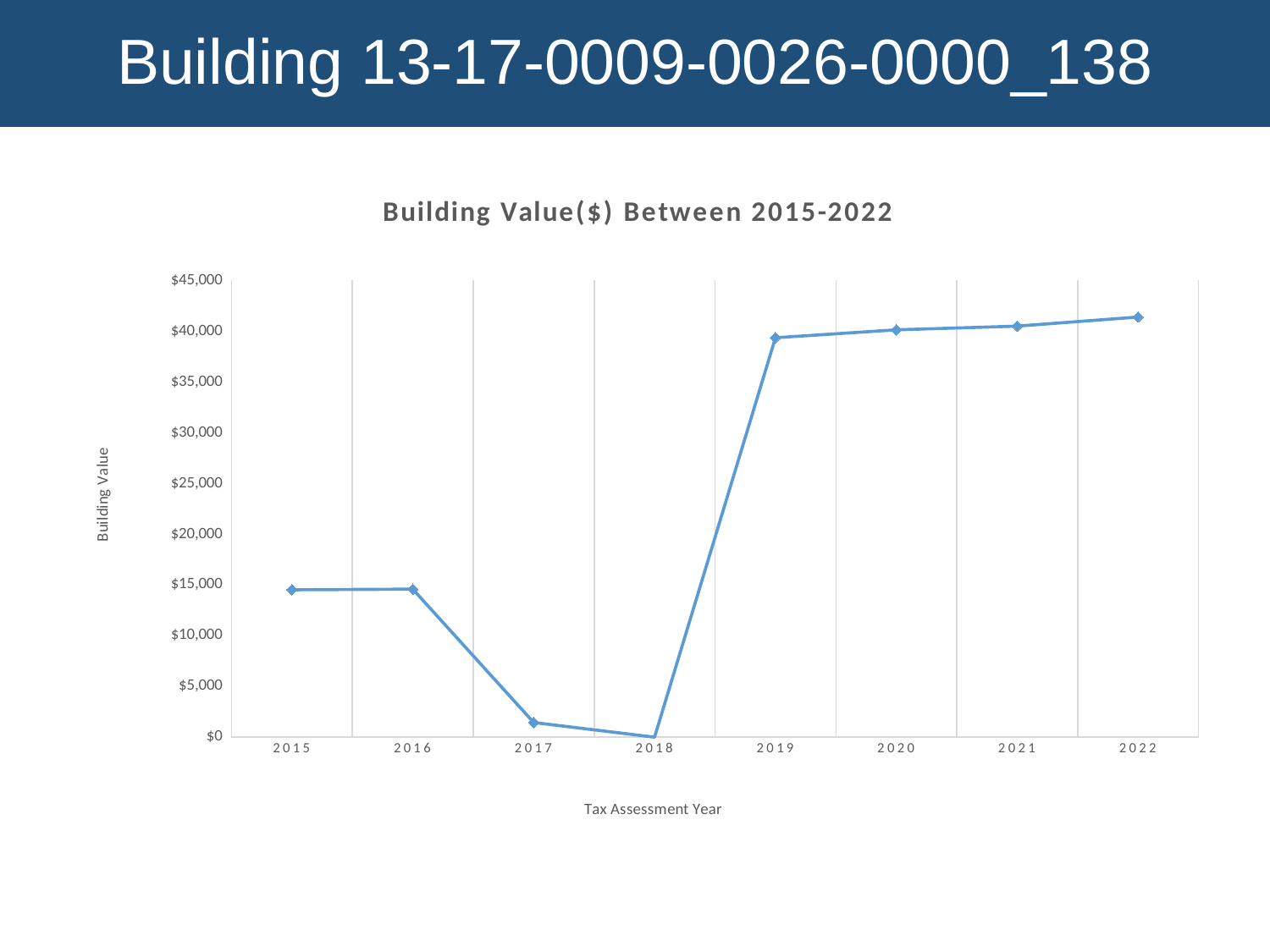
Is the building value for 2015 greater or less than $15,000? less What kind of chart is shown on the slide? line chart Which year has the larger building value, 2016 or 2019? 2019 Which year has the lowest building value? 2018 Is the building value for 2022 greater or less than $40,000? greater Does the building value rise or fall between 2016 and 2018? fall Is the building value for 2017 greater or less than $5,000? less What is the label on the x axis of the chart? Tax Assessment Year What is the building value in 2018? $0 What is the title of the chart? Building Value($) Between 2015-2022 How many tax assessment years are plotted on the chart? 8